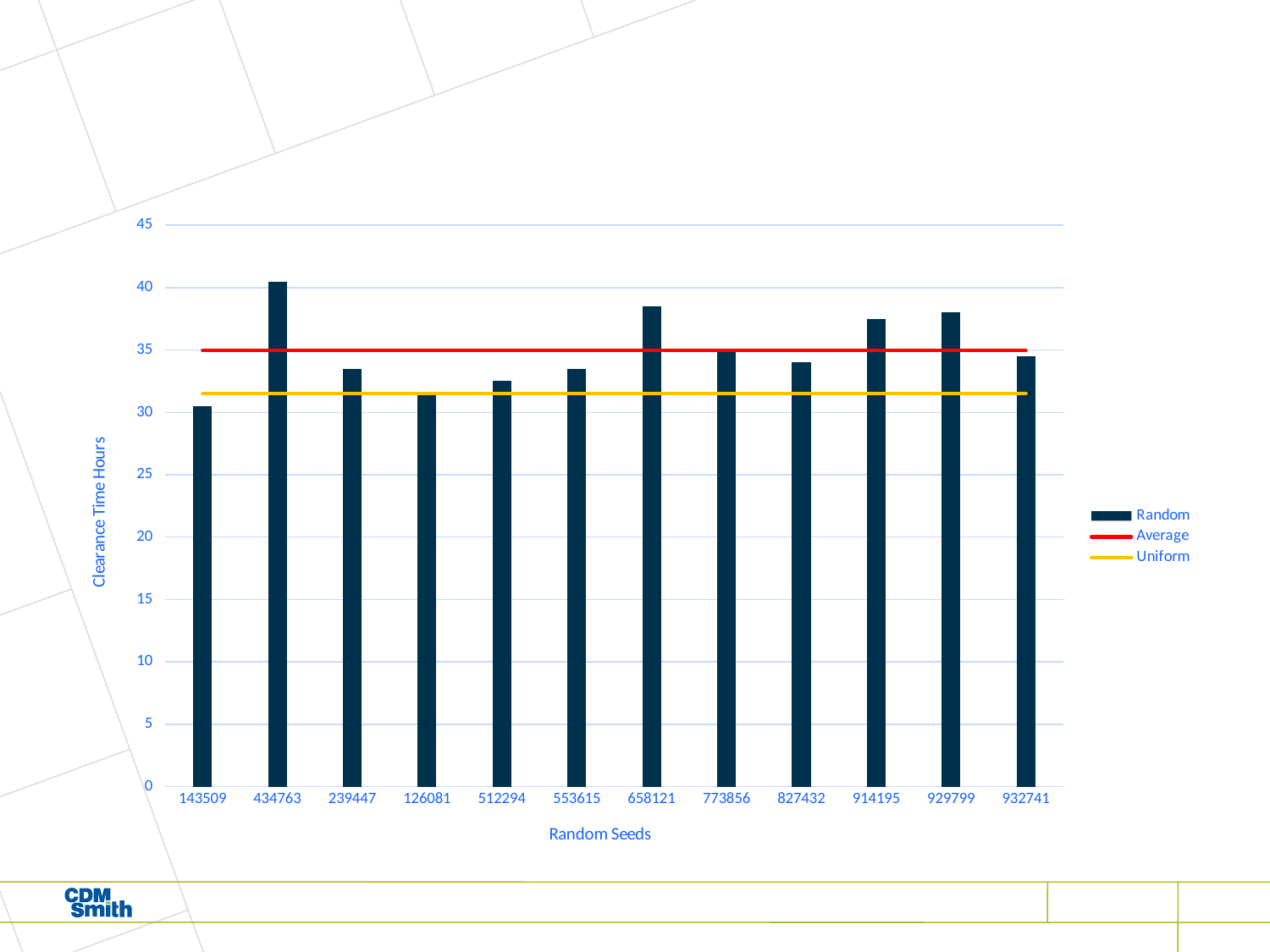
How many random seeds (categories) are plotted on the x axis? 12 Which random seed has the lowest clearance time? 143509 Which has a larger clearance time, seed 658121 or seed 239447? 658121 Which legend entry is drawn as a red line? Average Is the clearance time for seed 434763 greater or less than 35? greater What is the title of the y axis? Clearance Time Hours Which random seed has the highest clearance time? 434763 Is the clearance time for seed 126081 greater or less than 35? less How many series does the legend list? 3 What kind of chart is shown on the slide? Bar chart Is the clearance time for seed 658121 greater or less than 35? greater